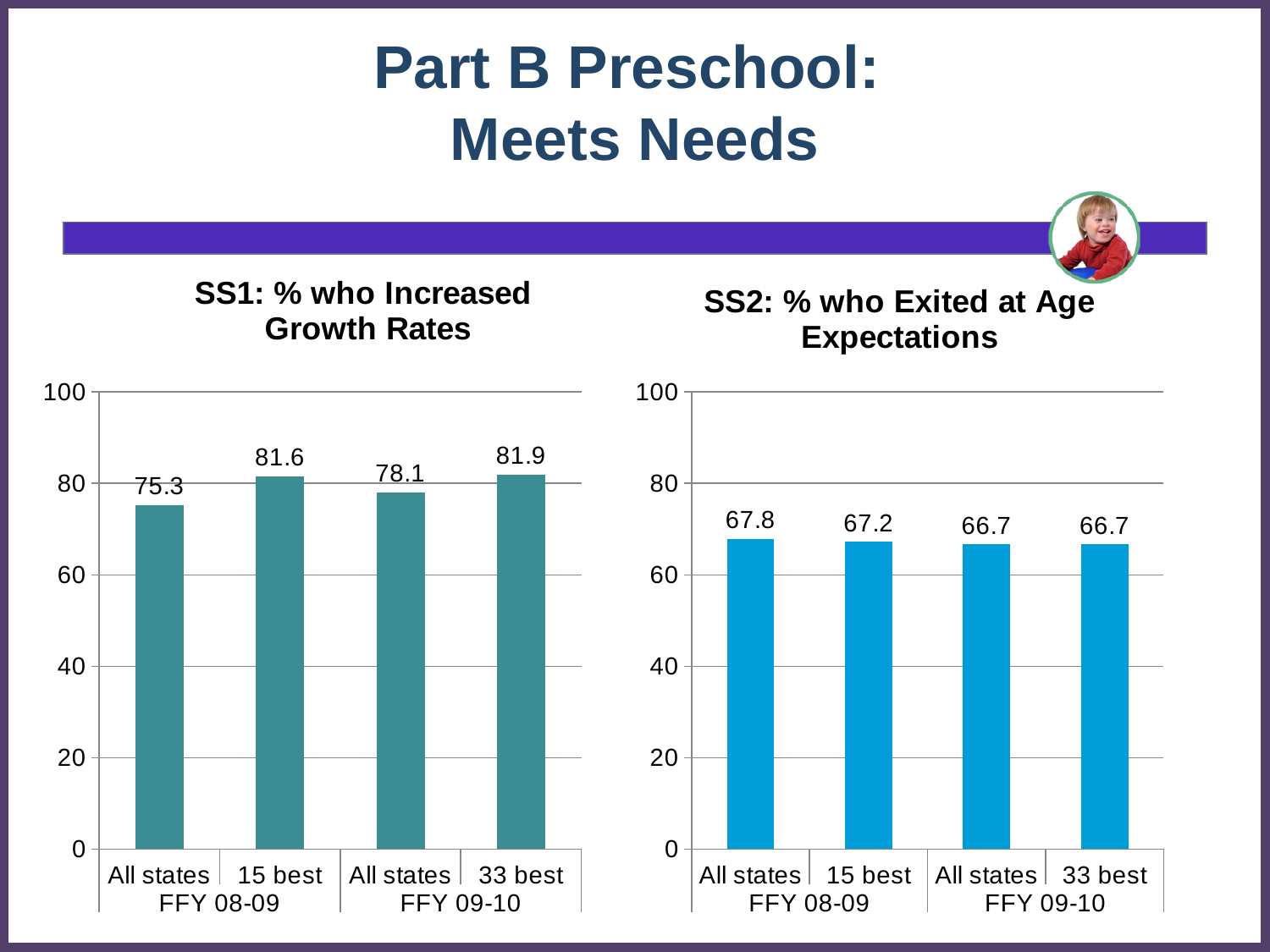
In the SS1: % who Increased Growth Rates chart, which is larger: All states in FFY 08-09 or All states in FFY 09-10? All states in FFY 09-10 How many bars are plotted in the SS2: % who Exited at Age Expectations chart? 4 In the SS2: % who Exited at Age Expectations chart, what is the value for 15 best in FFY 08-09? 67.2 In the SS1: % who Increased Growth Rates chart, which bar has the lowest value? All states, FFY 08-09 In the SS1: % who Increased Growth Rates chart, what is the difference between 15 best in FFY 08-09 and All states in FFY 08-09? 6.3 What type of chart is the SS1: % who Increased Growth Rates chart? Bar chart In the SS2: % who Exited at Age Expectations chart, what is the difference between All states in FFY 08-09 and 33 best in FFY 09-10? 1.1 In the SS1: % who Increased Growth Rates chart, what is the value for All states in FFY 08-09? 75.3 In the SS2: % who Exited at Age Expectations chart, is the value for All states in FFY 09-10 greater or less than 80? less In the SS2: % who Exited at Age Expectations chart, which bar has the highest value? All states, FFY 08-09 In the SS1: % who Increased Growth Rates chart, what is the value for 33 best in FFY 09-10? 81.9 In the SS1: % who Increased Growth Rates chart, which bar has the highest value? 33 best, FFY 09-10